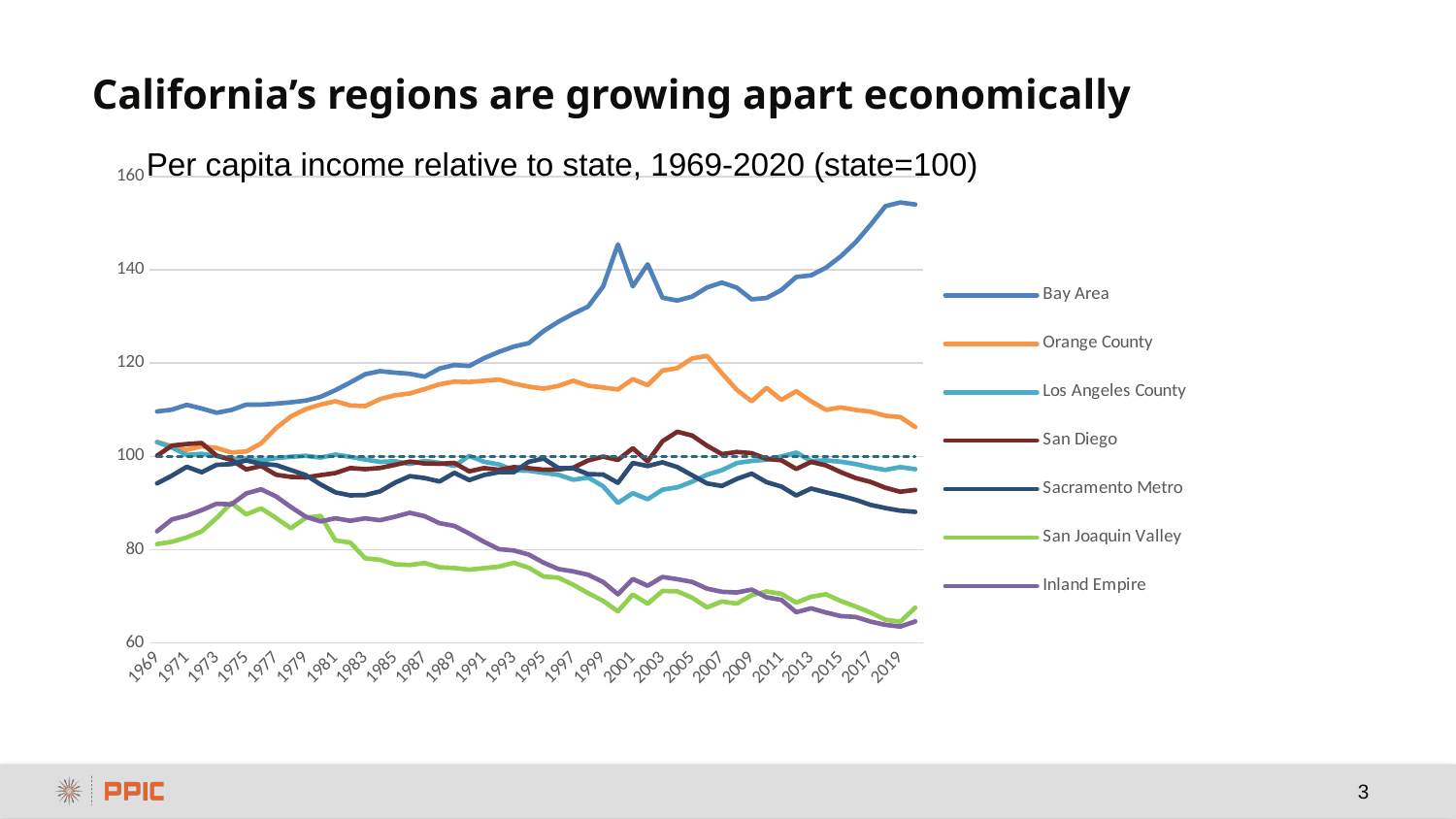
Is the value for Inland Empire in 2019 greater or less than 80? less In 2005, which is larger: the value for Bay Area or the value for Orange County? Bay Area Is the value for Bay Area in 2019 greater or less than 140? greater Which series has the highest value in 2019? Bay Area Does the San Joaquin Valley line rise or fall overall from 1969 to 2019? fall What is the title of the chart? Per capita income relative to state, 1969-2020 (state=100) What kind of chart is shown on the slide? line chart Which series is shown in orange in the legend? Orange County Is the value for Sacramento Metro in 2019 greater or less than 100? less How many series does the legend list? 7 Does the Bay Area line rise or fall overall from 1969 to 2019? rise